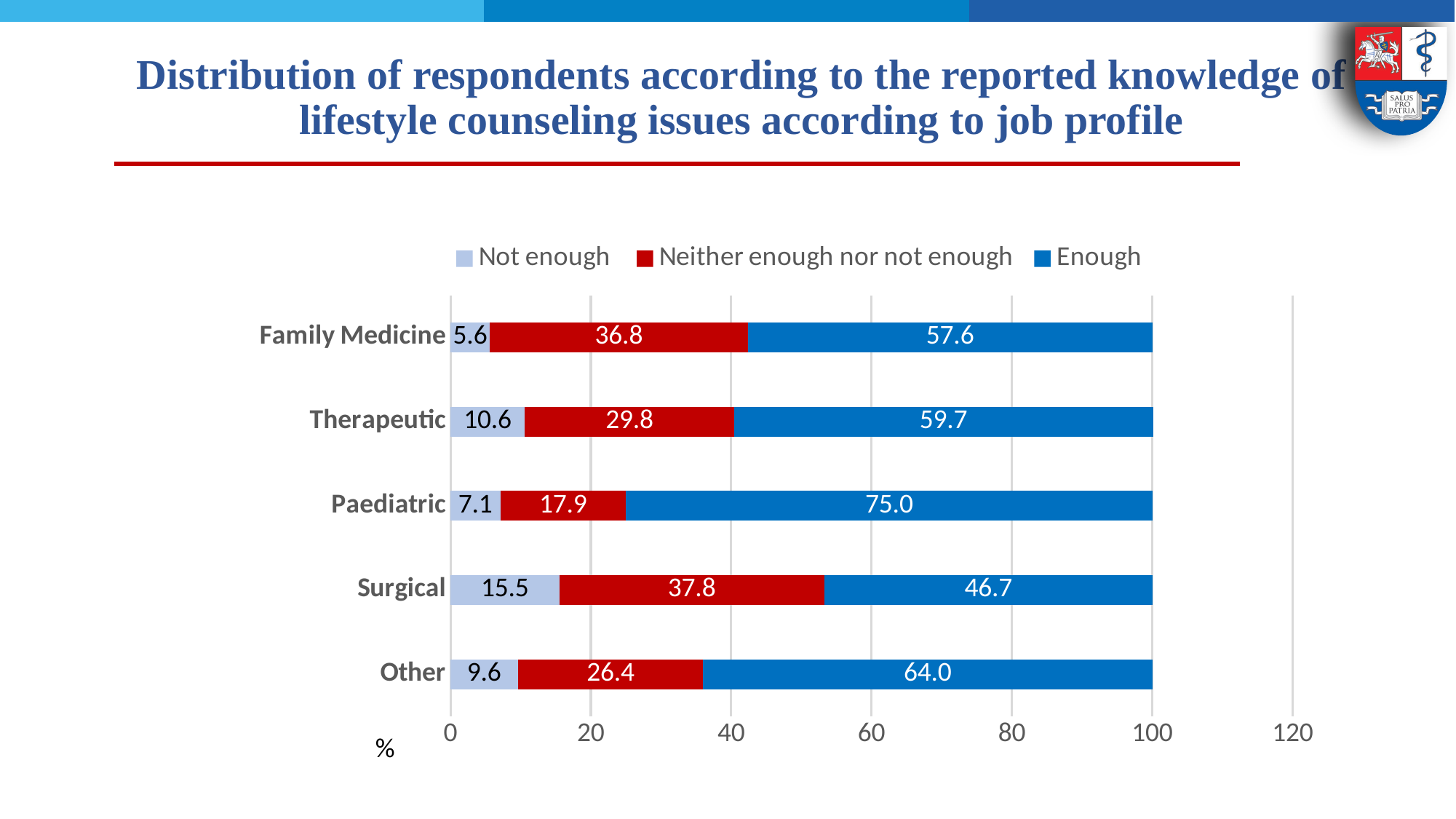
What is the 'Not enough' value for Surgical? 15.5 Which job profile has the lowest 'Not enough' value? Family Medicine What is the 'Enough' value for Paediatric? 75.0 What kind of chart is shown on the slide? Stacked bar chart What is the 'Neither enough nor not enough' value for Therapeutic? 29.8 How many series does the legend list? 3 What colour represents the 'Enough' series in the chart? Blue Which job profile has the highest 'Enough' value? Paediatric How many job profile categories are shown in the chart? 5 Which is larger: the 'Neither enough nor not enough' value for Family Medicine or for Other? Family Medicine What is the difference between the 'Enough' values for Paediatric and Surgical? 28.3 What is the total of the stacked bar for Surgical? 100.0